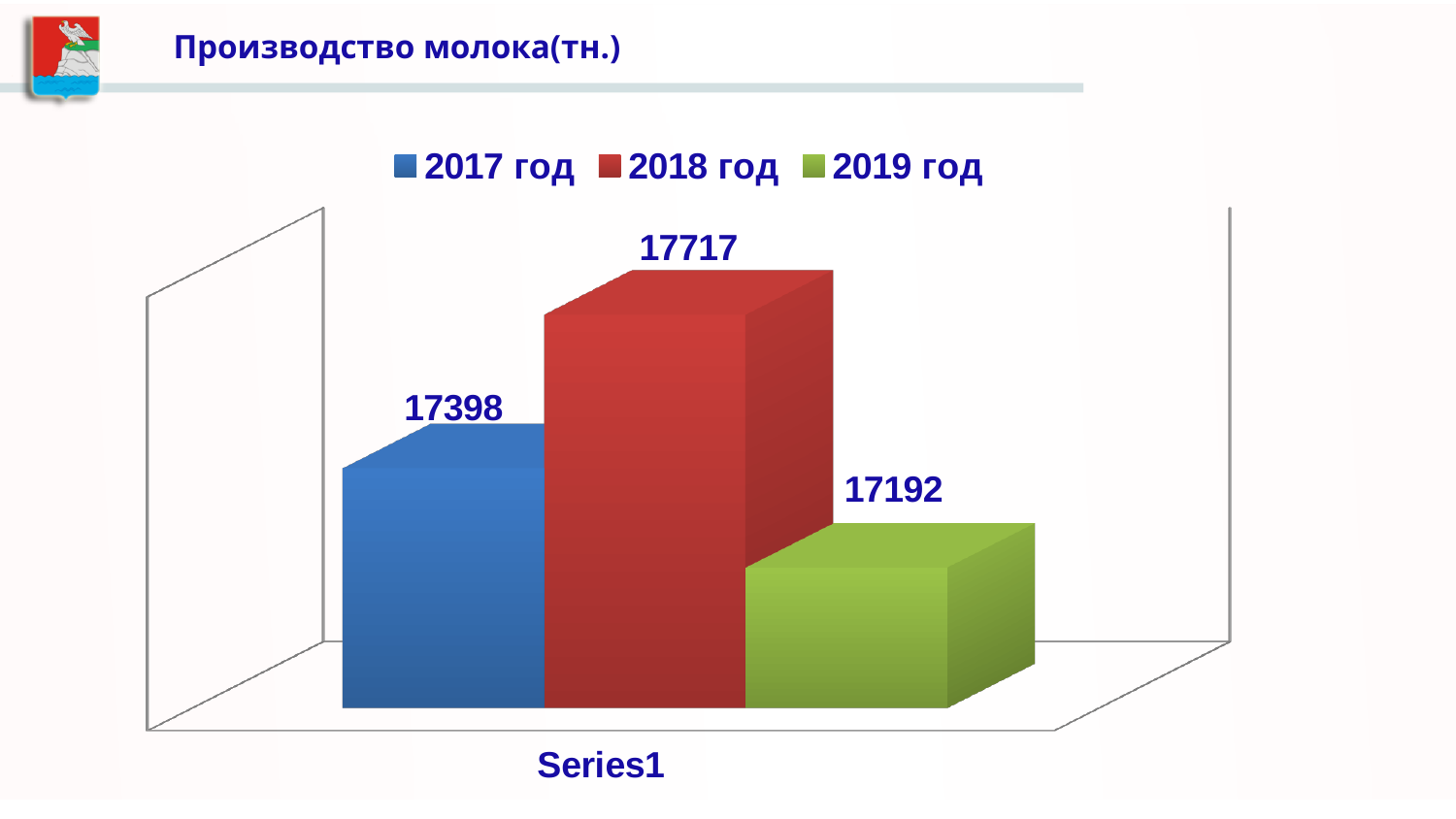
What is the title of the slide? Производство молока(тн.) What colour is the bar for 2018 год? red Which year has the lowest value? 2019 год What is the value for 2018 год? 17717 What is the value for 2017 год? 17398 What is the difference between the values for 2017 год and 2019 год? 206 Which year has the highest value? 2018 год How many series does the legend list? 3 What kind of chart is shown on the slide? bar chart Which is larger, the value for 2017 год or the value for 2019 год? 2017 год What is the value for 2019 год? 17192 What is the difference between the values for 2018 год and 2017 год? 319